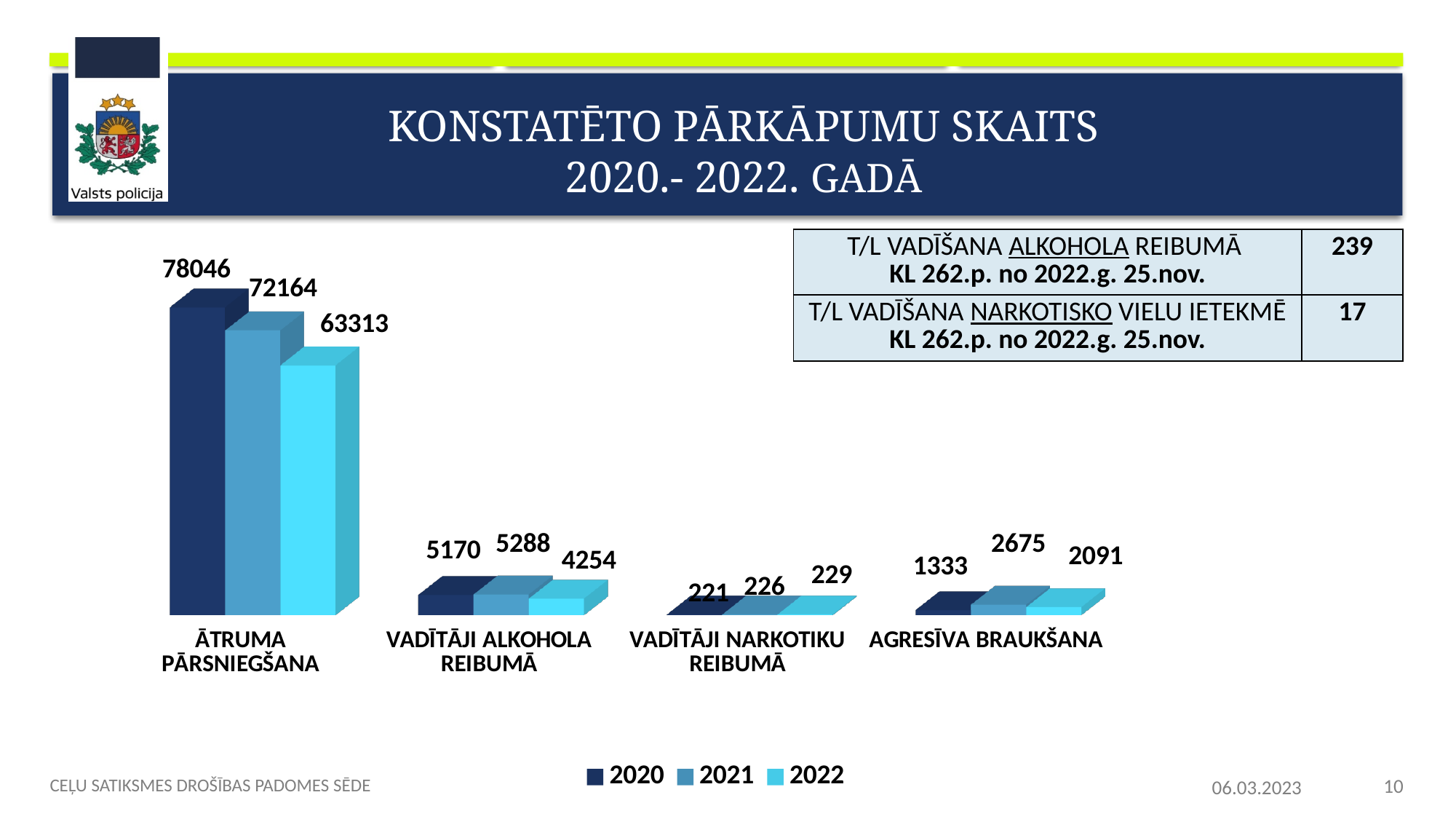
What kind of chart is shown on the slide? bar chart What is the value for VADĪTĀJI ALKOHOLA REIBUMĀ in 2022? 4254 Which category has the highest value in 2022? ĀTRUMA PĀRSNIEGŠANA What is the value for AGRESĪVA BRAUKŠANA in 2021? 2675 How many categories are shown on the x axis? 4 Which category has the lowest value in 2021? VADĪTĀJI NARKOTIKU REIBUMĀ How many series does the legend list? 3 Do the values for ĀTRUMA PĀRSNIEGŠANA rise or fall from 2020 to 2022? fall What is the value for ĀTRUMA PĀRSNIEGŠANA in 2020? 78046 What is the difference between the 2020 and 2022 values for ĀTRUMA PĀRSNIEGŠANA? 14733 What is the value for VADĪTĀJI NARKOTIKU REIBUMĀ in 2020? 221 Which is larger for AGRESĪVA BRAUKŠANA: the 2020 value or the 2022 value? 2022